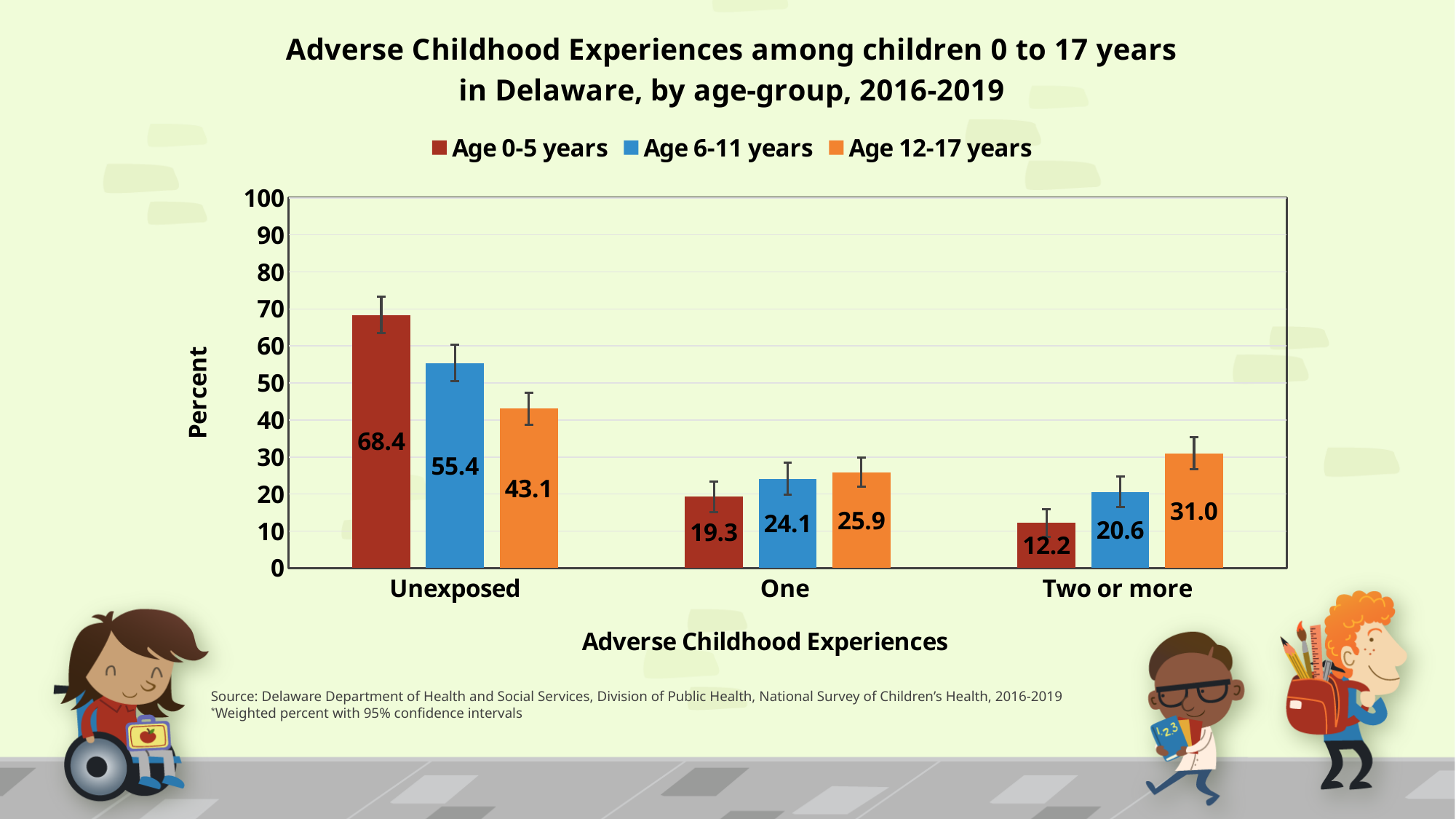
How many categories are shown on the x axis? 3 How many series does the legend list? 3 Is the value for Age 6-11 years in the Unexposed category greater or less than 50? greater What kind of chart is shown on the slide? Bar chart What is the difference between the Age 0-5 years and Age 12-17 years values in the Unexposed category? 25.3 What is the label of the y axis? Percent Which is larger: the Age 6-11 years value for Two or more, or the Age 0-5 years value for One? Age 6-11 years value for Two or more What is the value for Age 6-11 years in the One category? 24.1 Which age group has the lowest value in the Two or more category? Age 0-5 years What is the value for Age 0-5 years in the Unexposed category? 68.4 What is the value for Age 12-17 years in the Two or more category? 31.0 Which age group has the highest value in the Unexposed category? Age 0-5 years